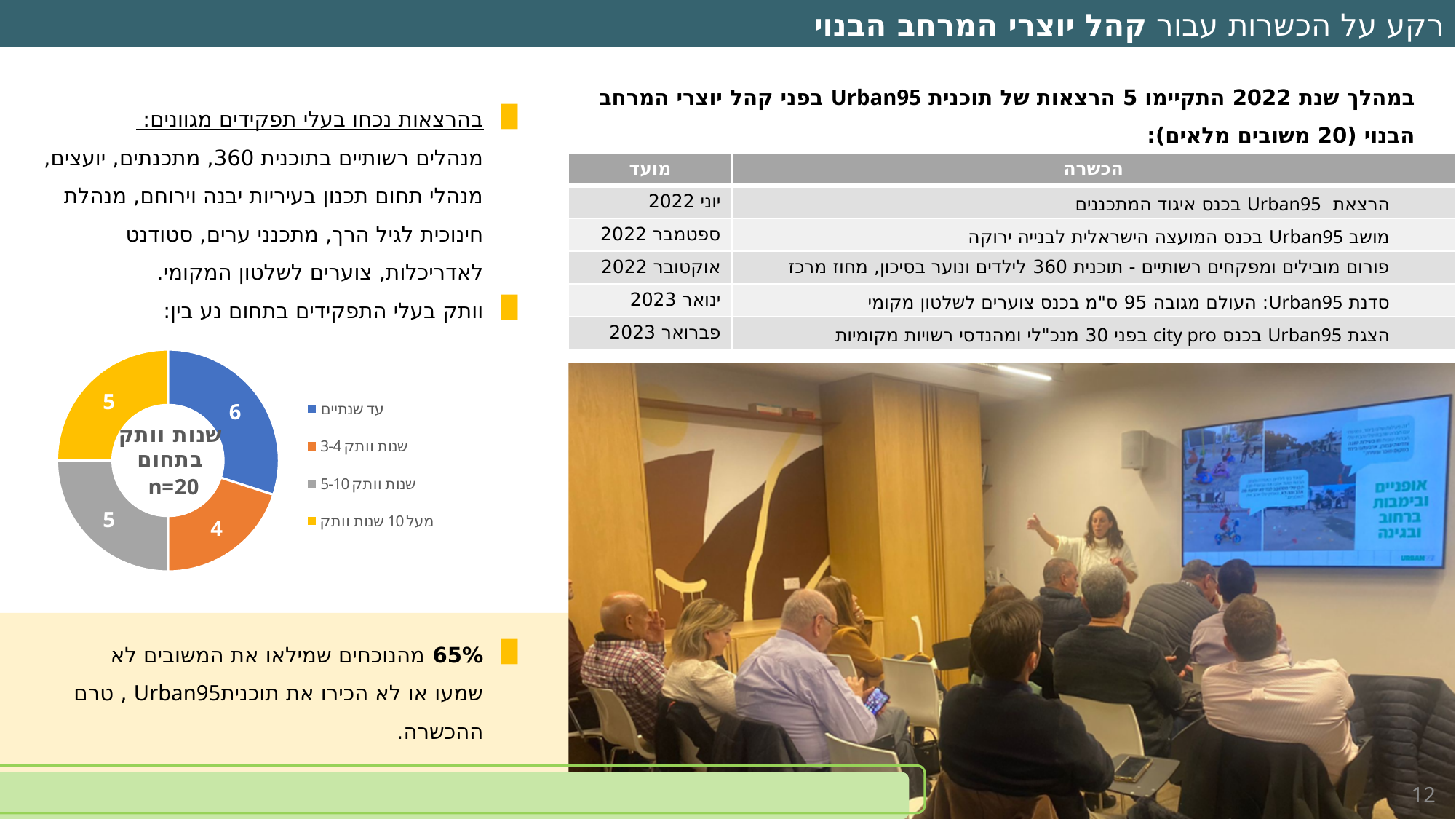
How many categories does the donut chart show? 4 Which is larger: the value for 'עד שנתיים' or the value for 'שנות וותק 3-4'? עד שנתיים What share of the total does the 'עד שנתיים' slice represent? 30% Which category has the lowest value in the donut chart? שנות וותק 3-4 What is the value for the category 'שנות וותק 3-4' in the donut chart? 4 What kind of chart is shown on the slide? Donut (pie) chart What is the value for the category 'מעל 10 שנות וותק' in the donut chart? 5 What is the value for the category 'שנות וותק 5-10' in the donut chart? 5 What is the difference between the values for 'עד שנתיים' and 'שנות וותק 3-4'? 2 What is the value for the category 'עד שנתיים' in the donut chart? 6 Which category has the highest value in the donut chart? עד שנתיים What is the title shown in the centre of the donut chart? שנות וותק בתחום n=20